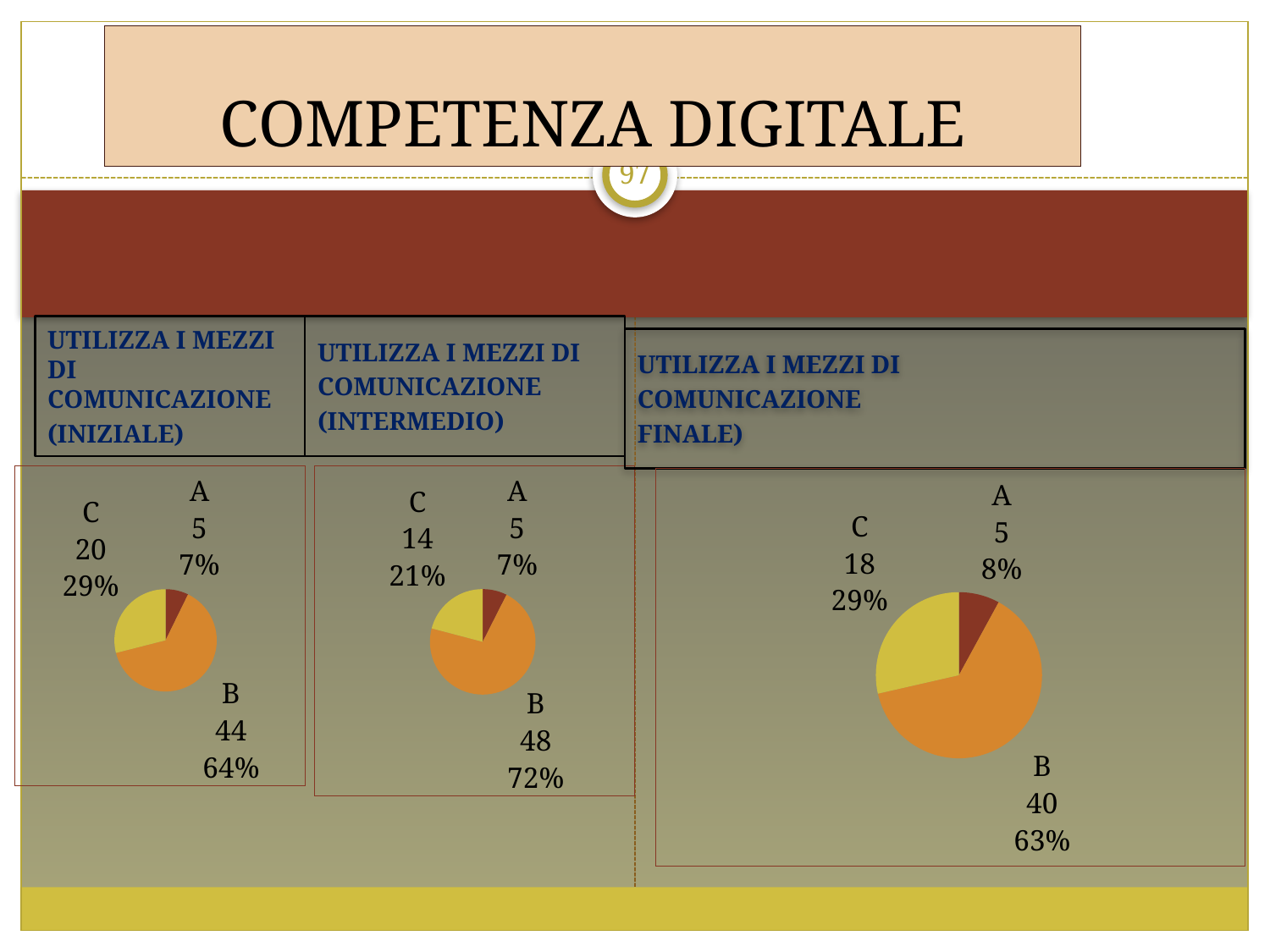
In the UTILIZZA I MEZZI DI COMUNICAZIONE FINALE chart, what is the value for B? 40 In the UTILIZZA I MEZZI DI COMUNICAZIONE (INIZIALE) chart, what is the value for B? 44 In the UTILIZZA I MEZZI DI COMUNICAZIONE FINALE chart, which category has the smallest slice? A In the UTILIZZA I MEZZI DI COMUNICAZIONE FINALE chart, what share of the pie does A represent? 8% In the UTILIZZA I MEZZI DI COMUNICAZIONE (INIZIALE) chart, which category has the largest slice? B What kind of chart is used for UTILIZZA I MEZZI DI COMUNICAZIONE FINALE? Pie chart In the UTILIZZA I MEZZI DI COMUNICAZIONE (INIZIALE) chart, what share of the pie does C represent? 29% In the UTILIZZA I MEZZI DI COMUNICAZIONE (INTERMEDIO) chart, what is the difference between the values for B and C? 34 In the UTILIZZA I MEZZI DI COMUNICAZIONE (INTERMEDIO) chart, what is the value for C? 14 In the UTILIZZA I MEZZI DI COMUNICAZIONE FINALE chart, which is larger, the value for C or the value for A? C How many categories does the UTILIZZA I MEZZI DI COMUNICAZIONE (INIZIALE) chart show? 3 In the UTILIZZA I MEZZI DI COMUNICAZIONE (INTERMEDIO) chart, what share of the pie does B represent? 72%